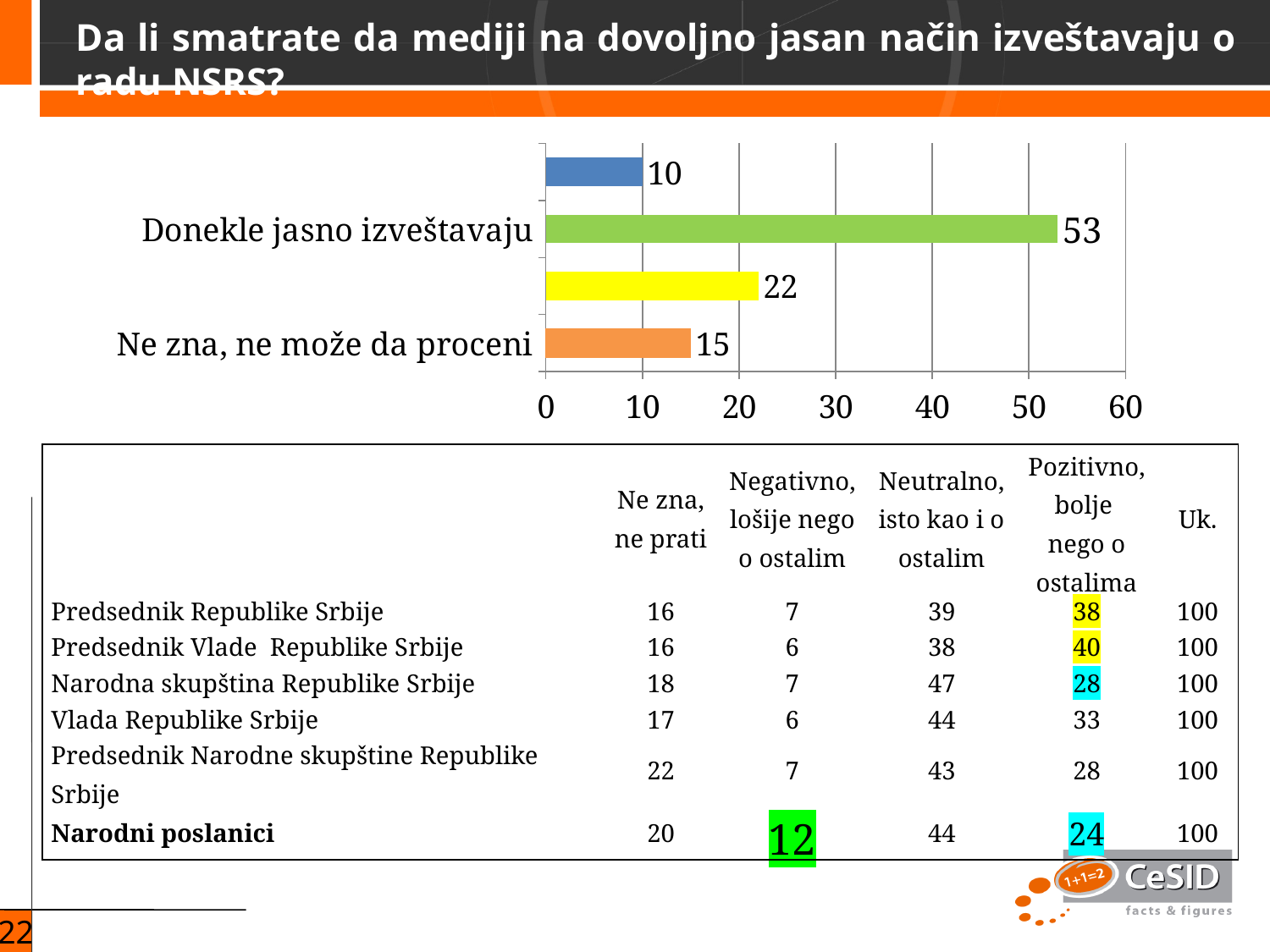
Which labelled category has the highest value in the bar chart? Donekle jasno izveštavaju What is the highest tick value shown on the chart's horizontal axis? 60 Which is larger: the value for "Donekle jasno izveštavaju" or for "Ne zna, ne može da proceni"? Donekle jasno izveštavaju What value is shown for "Donekle jasno izveštavaju"? 53 How many bars are plotted in the chart? 4 Is the value for "Ne zna, ne može da proceni" greater or less than 20? less What is the difference between the values for "Donekle jasno izveštavaju" and "Ne zna, ne može da proceni"? 38 What is the smallest value shown on any bar in the chart? 10 What value is shown for "Ne zna, ne može da proceni"? 15 What kind of chart is shown on the slide? Bar chart What colour is the bar for "Donekle jasno izveštavaju"? Green Is the value for "Donekle jasno izveštavaju" greater or less than 50? greater